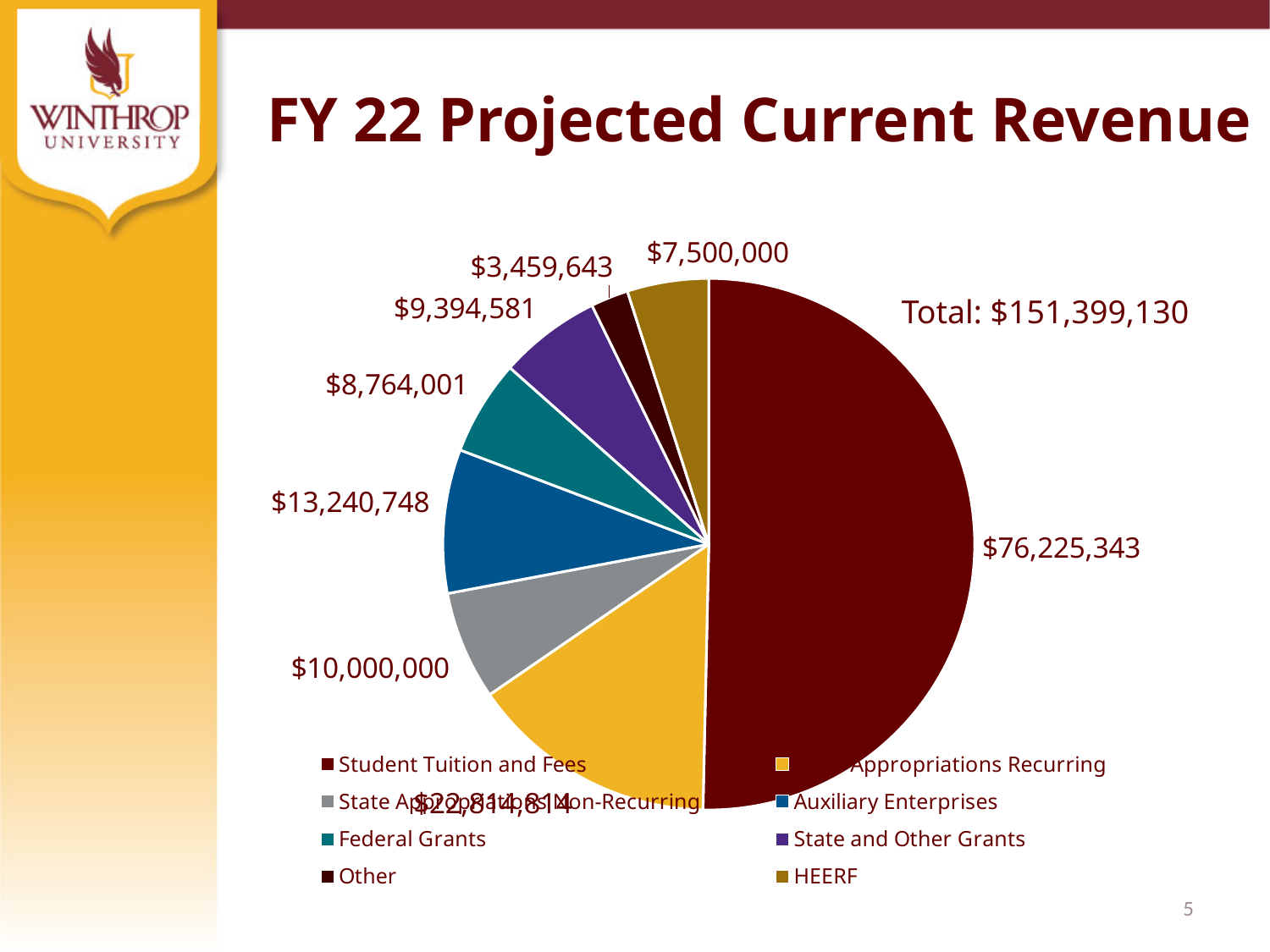
How many categories does the pie chart have? 8 What is the value for HEERF? $7,500,000 What is the difference between Auxiliary Enterprises and Federal Grants? $4,476,747 Which is larger, Federal Grants or State and Other Grants? State and Other Grants Which category has the smallest slice of the pie? Other What type of chart is shown on the slide? Pie chart What is the value for Auxiliary Enterprises? $13,240,748 What is the value for Student Tuition and Fees? $76,225,343 What is the difference between Student Tuition and Fees and State Appropriations Recurring? $53,410,529 What total revenue is stated on the slide? $151,399,130 What is the value for State Appropriations Non-Recurring? $10,000,000 Which category has the largest slice of the pie? Student Tuition and Fees